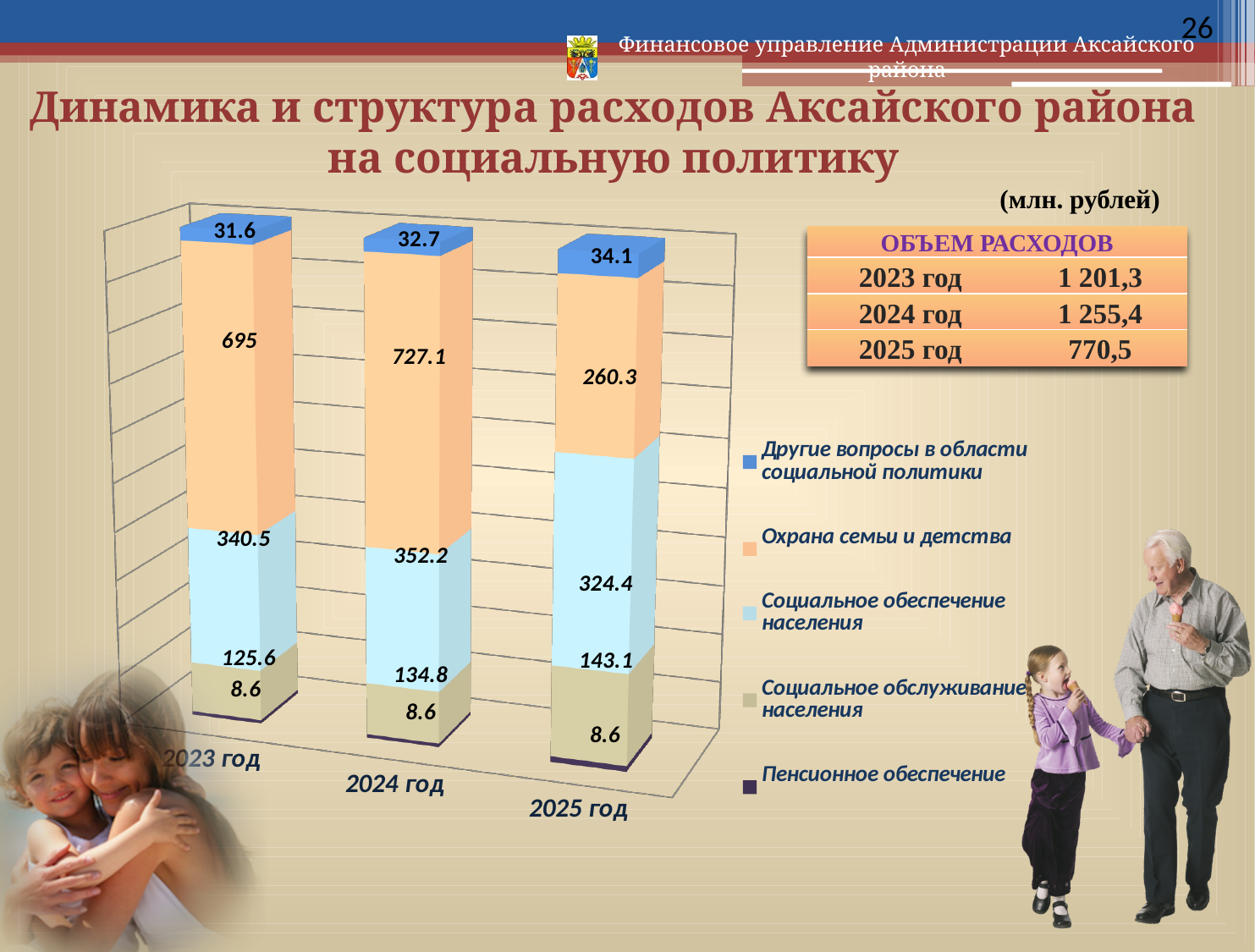
What is the value for Другие вопросы в области социальной политики in 2024 год? 32.7 What is the value for Охрана семьи и детства in 2023 год? 695 What is the value for Социальное обеспечение населения in 2025 год? 324.4 What is the difference between the Охрана семьи и детства values for 2024 год and 2025 год? 466.8 How many series does the chart legend list? 5 What kind of chart is shown on the slide? Stacked bar chart According to the table ОБЪЕМ РАСХОДОВ, what is the total expenditure for 2025 год? 770,5 Which is larger: Социальное обеспечение населения in 2023 год or in 2024 год? 2024 год In which year is the value for Охрана семьи и детства the highest? 2024 год How many years (categories) are shown on the x axis of the chart? 3 What is the value for Пенсионное обеспечение in 2025 год? 8.6 In which year is the value for Социальное обслуживание населения the lowest? 2023 год